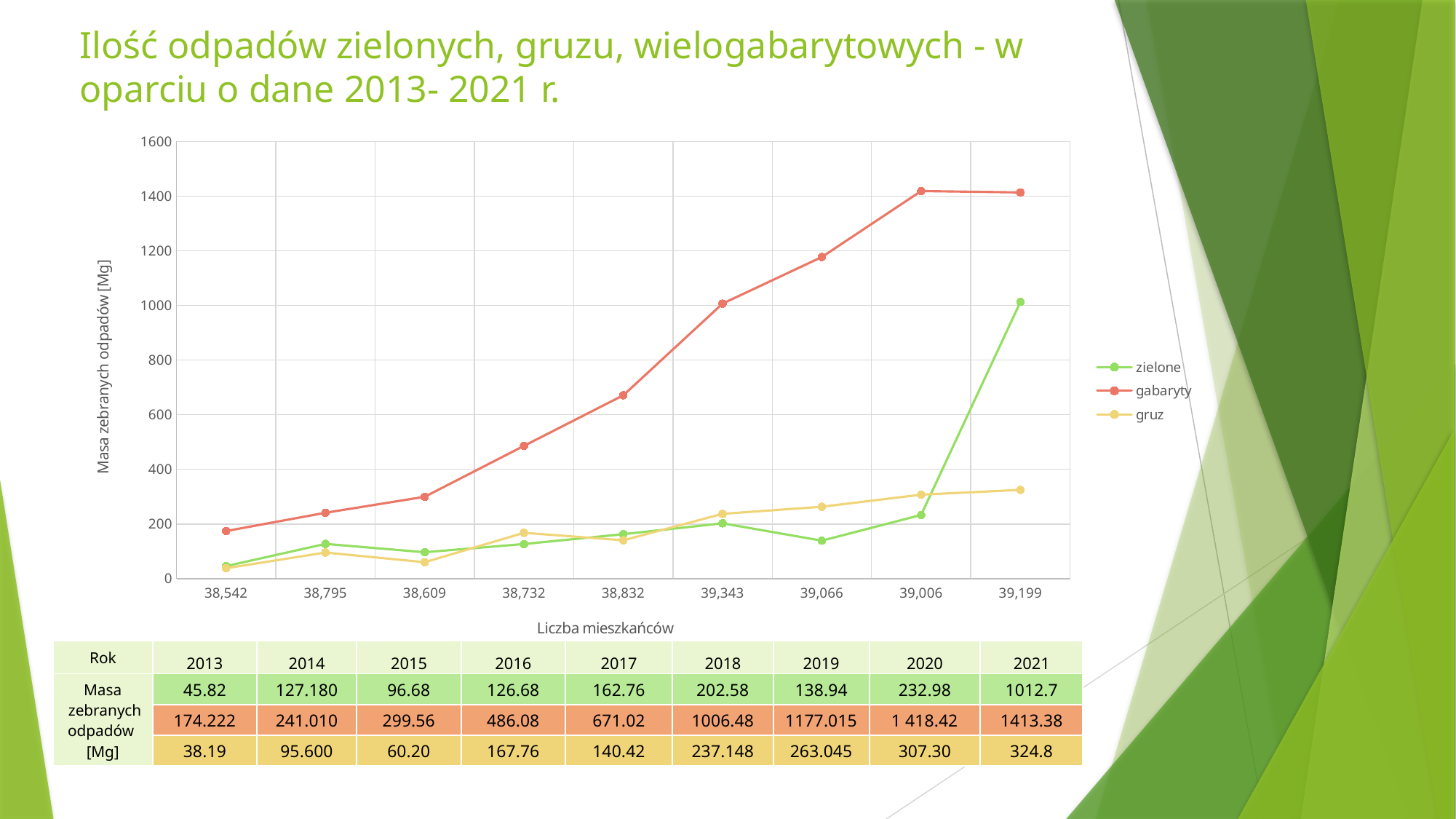
Is the gabaryty value at x-axis label 39,343 greater or less than 800? greater How many series does the chart legend list? 3 Using the table values for 2021, what is the difference between gabaryty (1413.38) and zielone (1012.7)? 400.68 Is the zielone value at x-axis label 39,006 greater or less than 400? less Does the gabaryty line generally rise or fall from left to right across the x axis? rise According to the table under the chart, what is the gabaryty value for 2021? 1413.38 What is the title of the chart's vertical axis? Masa zebranych odpadów [Mg] What kind of chart is shown on the slide? line chart At x-axis label 39,006, which is larger: gruz or zielone? gruz According to the table under the chart, what is the zielone value for 2021? 1012.7 Which series has the highest value at the last x-axis point (39,199)? gabaryty How many data points does each line in the chart have? 9